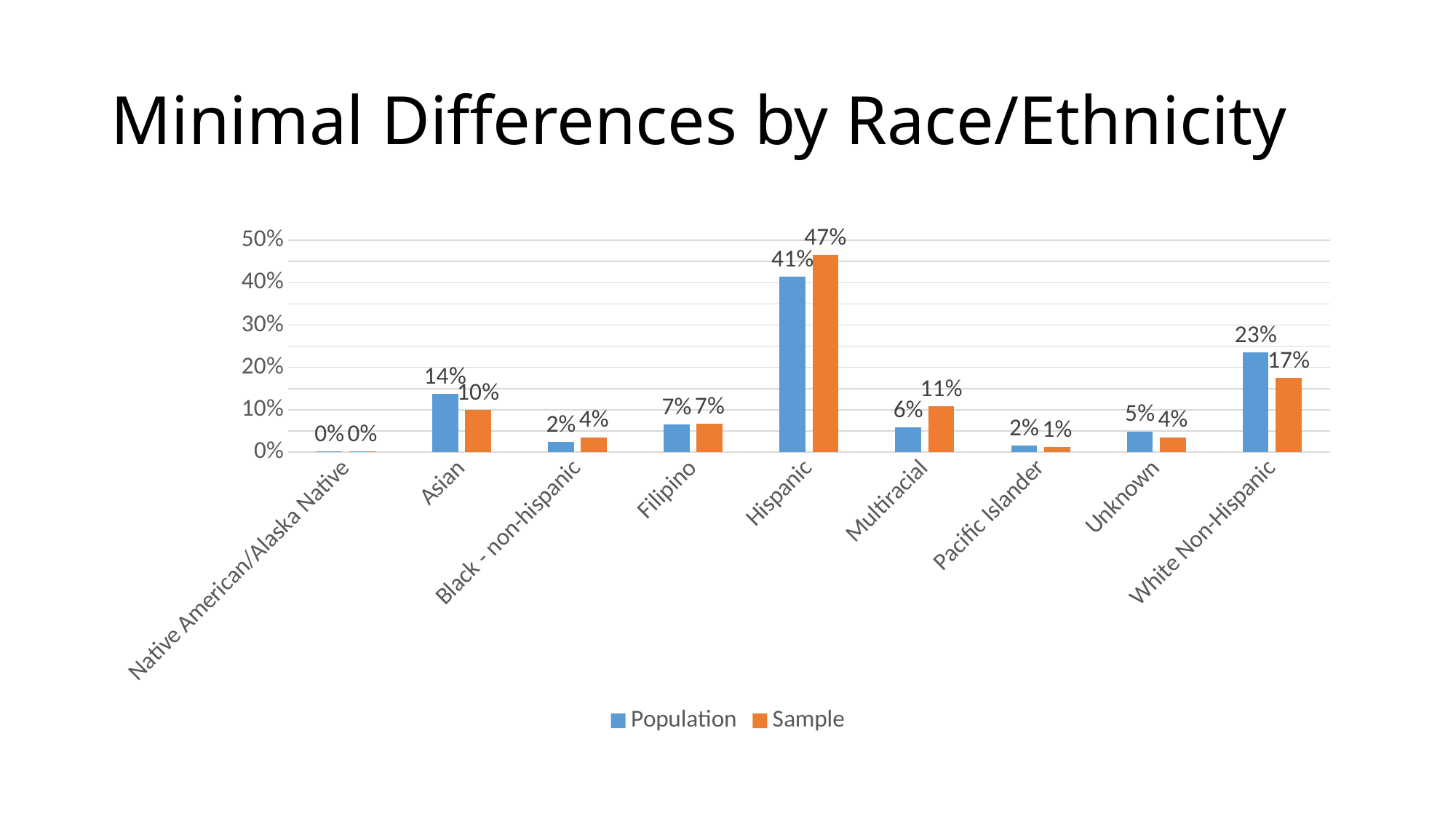
What kind of chart is shown on the slide? Bar chart How many race/ethnicity categories are shown on the x axis? 9 What is the Sample value for Hispanic? 47% Which category has the lowest Sample value? Native American/Alaska Native What is the Population value for White Non-Hispanic? 23% Which category has the highest Population value? Hispanic What is the difference between the Sample and Population values for Hispanic? 6% Which is larger for Multiracial, the Population value or the Sample value? Sample What is the difference between the Population and Sample values for White Non-Hispanic? 6% What is the title of the slide? Minimal Differences by Race/Ethnicity What is the Sample value for Asian? 10% How many series does the legend list? 2